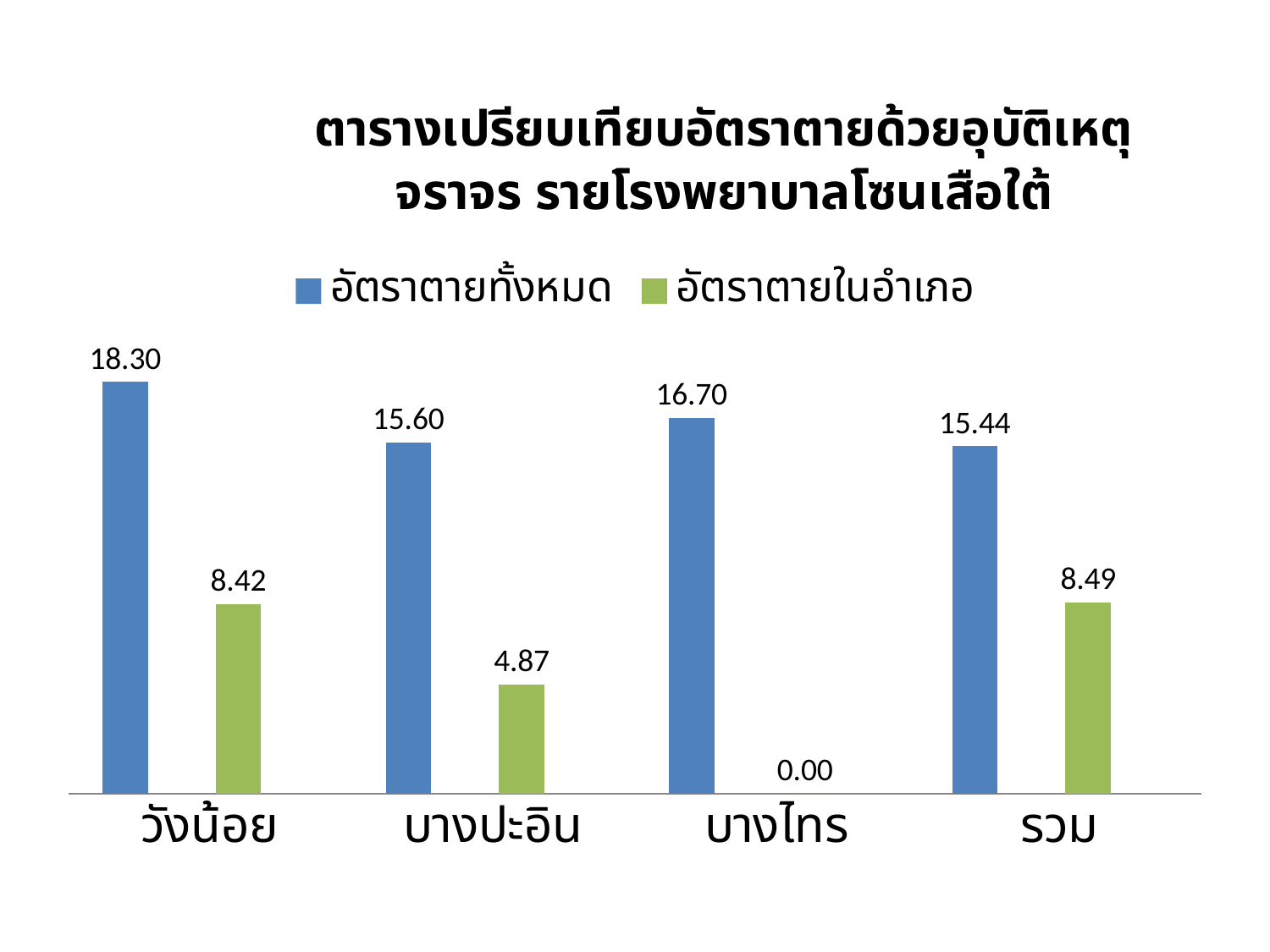
Which category has the highest value for อัตราตายทั้งหมด? วังน้อย How many series does the legend list? 2 What is the value of อัตราตายในอำเภอ for บางปะอิน? 4.87 What kind of chart is shown on the slide? Bar chart Which colour represents อัตราตายในอำเภอ in the legend? Green How many categories are shown on the x axis? 4 What is the difference between อัตราตายทั้งหมด and อัตราตายในอำเภอ for วังน้อย? 9.88 Which is larger: อัตราตายทั้งหมด for บางปะอิน or อัตราตายทั้งหมด for บางไทร? บางไทร What is the value of อัตราตายทั้งหมด for วังน้อย? 18.30 What is the value of อัตราตายในอำเภอ for บางไทร? 0.00 Which category has the lowest value for อัตราตายในอำเภอ? บางไทร What is the value of อัตราตายทั้งหมด for รวม? 15.44